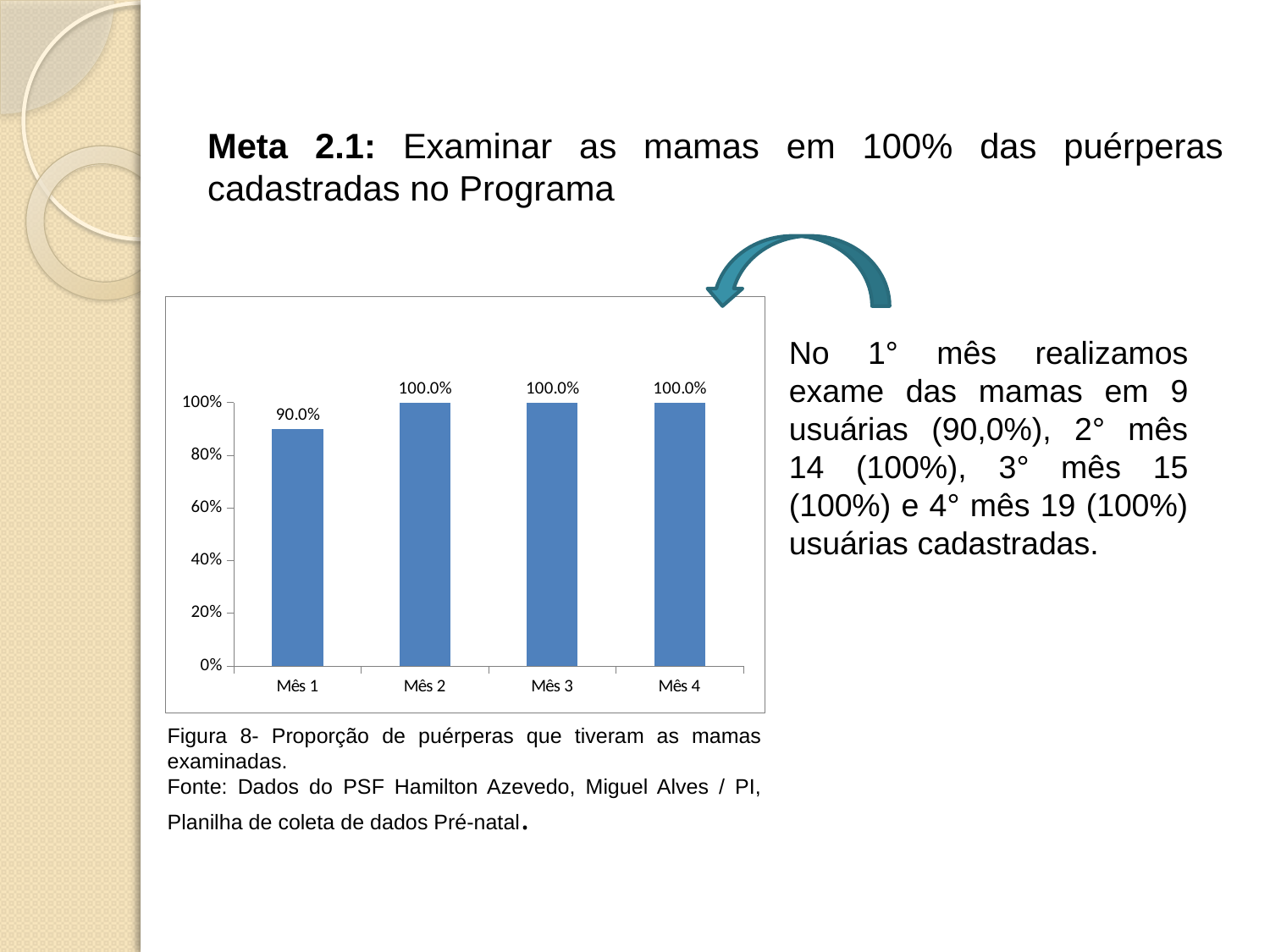
Which is larger, the value for Mês 1 or the value for Mês 3? Mês 3 How many categories are shown on the x axis? 4 What is the value for Mês 2? 100.0% What is the value for Mês 4? 100.0% What is the value for Mês 1? 90.0% How many categories have a value of 100.0%? 3 Do the values rise or fall from Mês 1 to Mês 2? rise Is the value for Mês 1 greater or less than 80%? greater What is the difference between the values for Mês 2 and Mês 1? 10.0% Which category has the lowest value? Mês 1 What kind of chart is shown on the slide? bar chart What is the highest value shown on the y axis? 100%